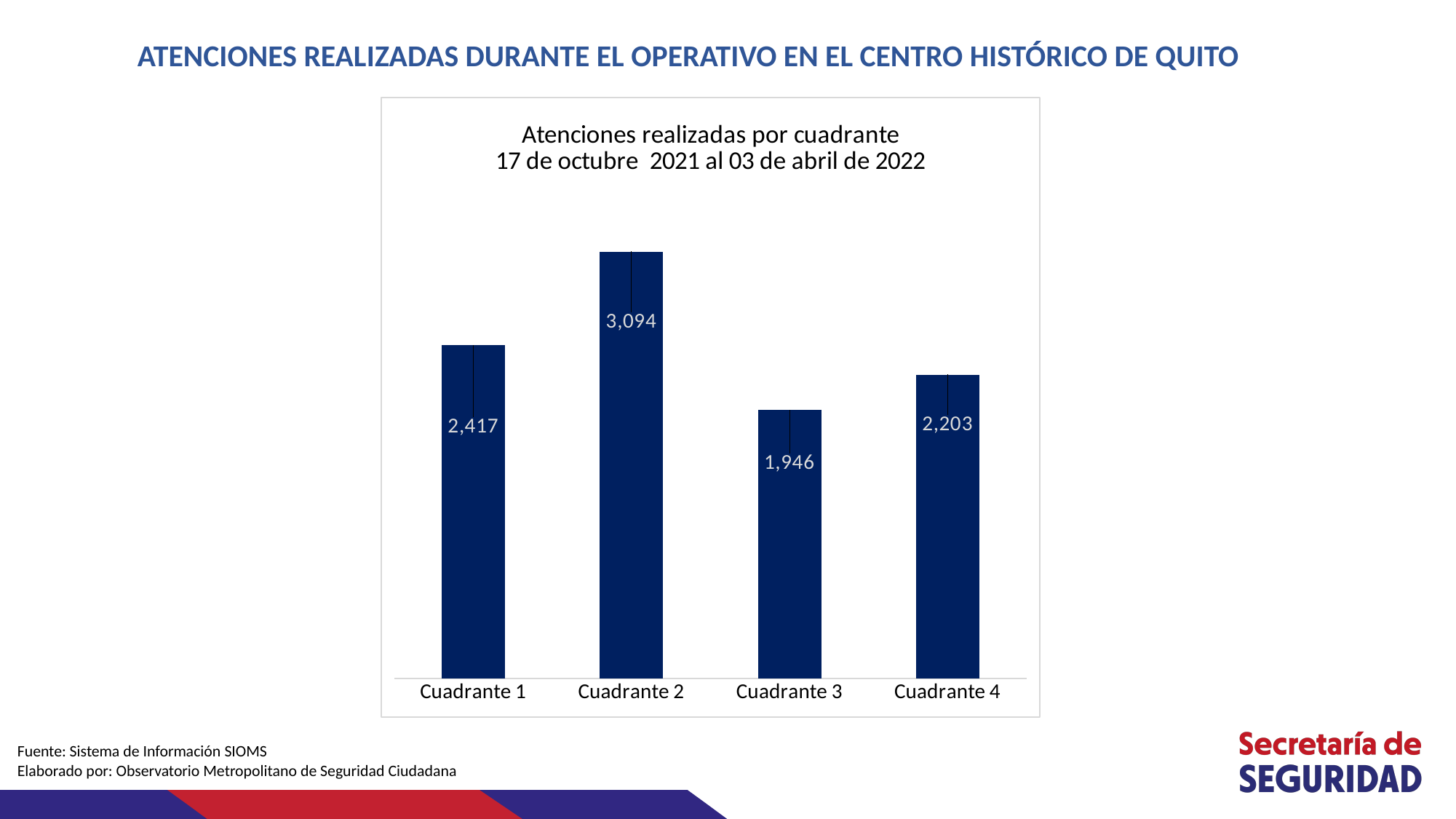
How many cuadrantes are shown in the chart? 4 What is the title of the chart? Atenciones realizadas por cuadrante 17 de octubre 2021 al 03 de abril de 2022 What is the difference between the values for Cuadrante 1 and Cuadrante 4? 214 What is the value for Cuadrante 3? 1,946 What kind of chart is shown on the slide? Bar chart Which cuadrante has the highest number of atenciones? Cuadrante 2 What is the value for Cuadrante 4? 2,203 What is the difference between the values for Cuadrante 2 and Cuadrante 3? 1,148 What is the value for Cuadrante 2? 3,094 Which cuadrante has the lowest number of atenciones? Cuadrante 3 What is the value for Cuadrante 1? 2,417 Which is larger, the value for Cuadrante 1 or Cuadrante 4? Cuadrante 1